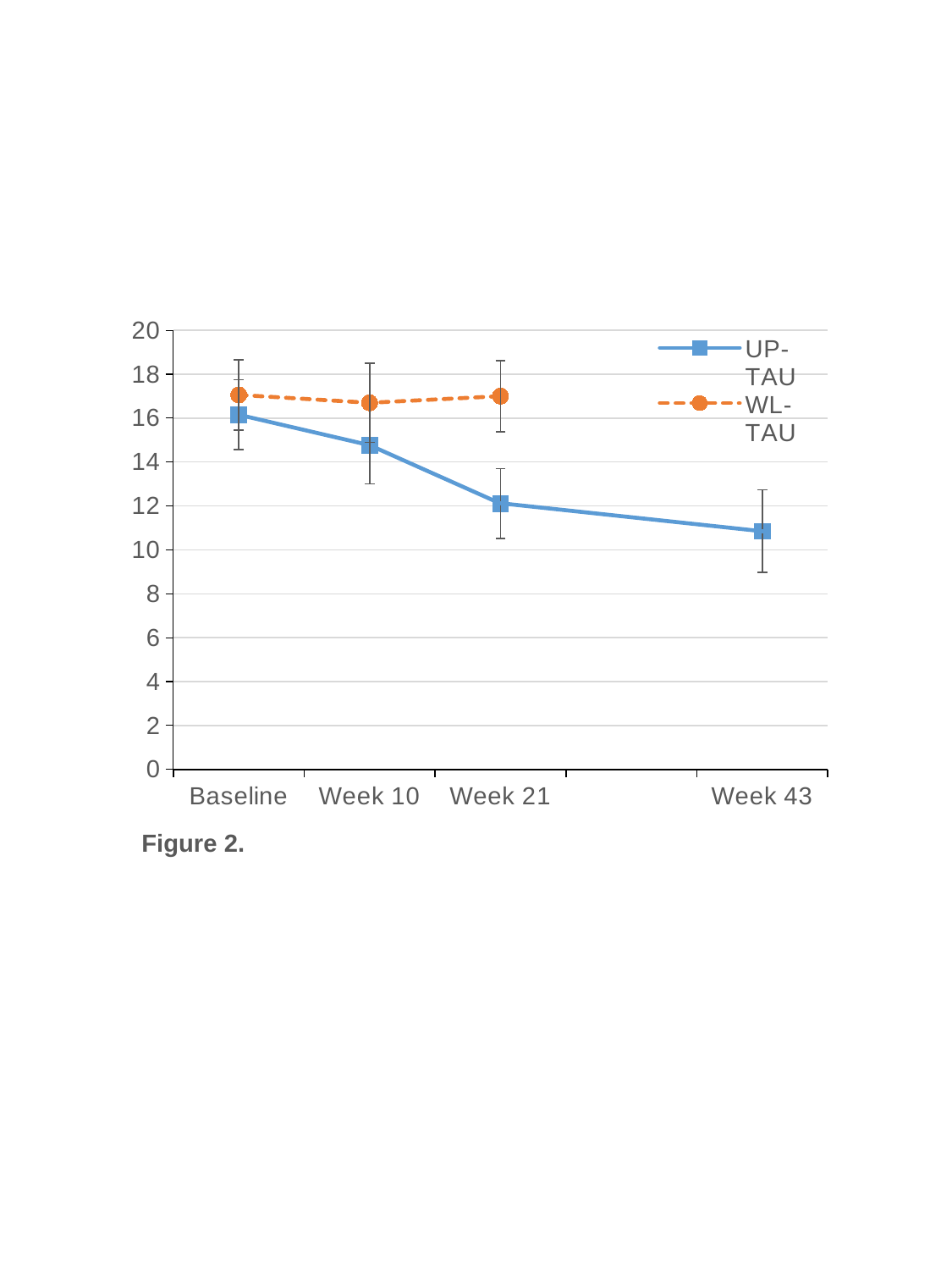
Is the UP-TAU value at Week 43 greater or less than 12? less At Week 21, which series has the higher value, UP-TAU or WL-TAU? WL-TAU Which series is drawn with a dashed line? WL-TAU Does the UP-TAU series rise or fall from Baseline to Week 43? fall How many categories are shown on the x axis? 4 How many data points are plotted for the WL-TAU series? 3 Is the UP-TAU value at Baseline greater or less than 14? greater What kind of chart is shown on the slide? line chart How many series does the legend list? 2 At which category is the UP-TAU value lowest? Week 43 At which category is the UP-TAU value highest? Baseline Is the WL-TAU value at Week 21 greater or less than 16? greater